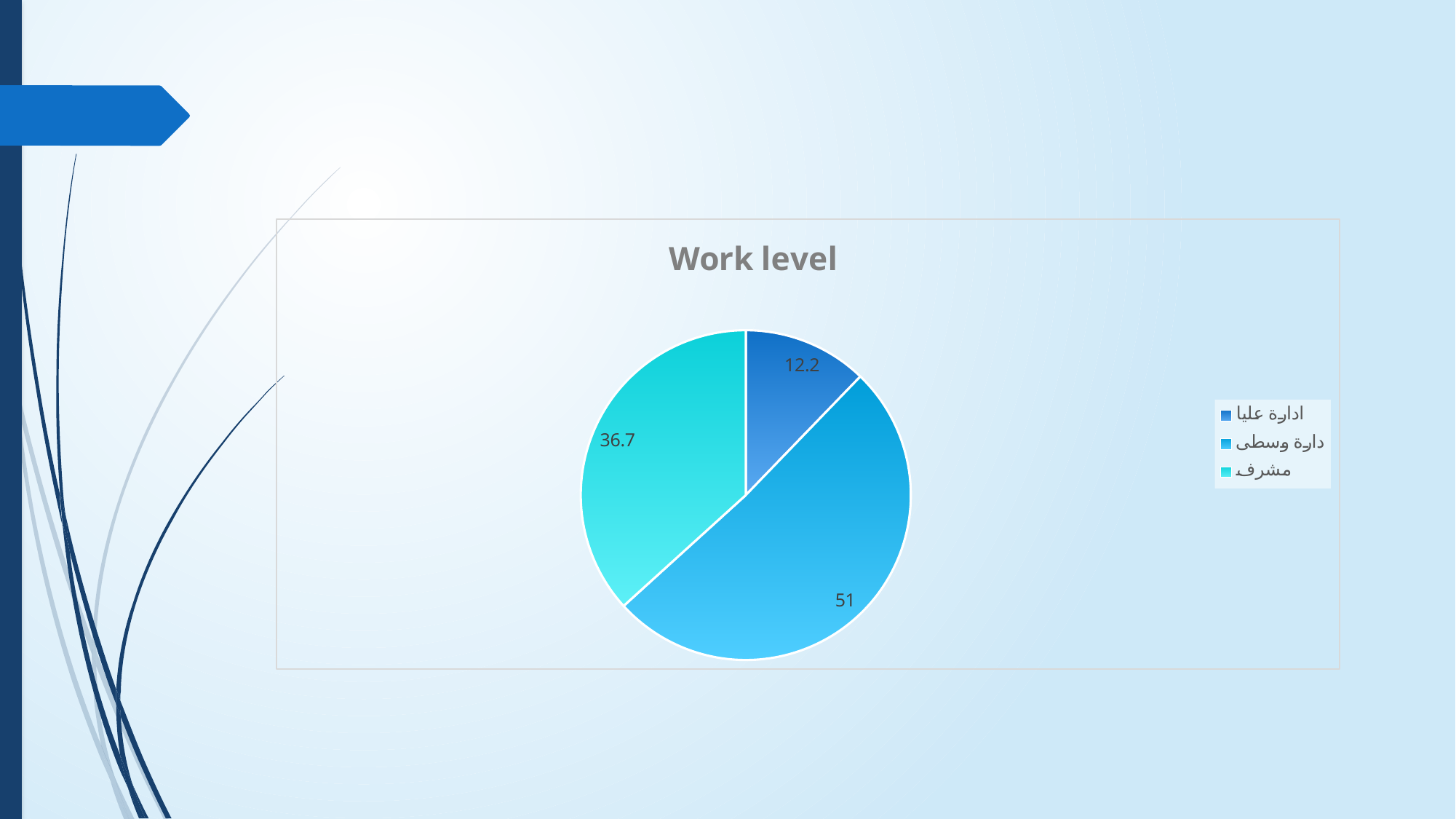
Which is larger, the value for مشرف or the value for ادارة عليا? مشرف What is the difference between the values for دارة وسطى and مشرف? 14.3 What is the difference between the values for مشرف and ادارة عليا? 24.5 How many slices does the Work level pie chart have? 3 What type of chart is shown on the slide? pie chart How many entries does the legend list? 3 Which category has the smallest slice in the Work level pie chart? ادارة عليا What is the value for مشرف in the Work level pie chart? 36.7 What is the value for دارة وسطى in the Work level pie chart? 51 What is the title of the chart? Work level Which category has the largest slice in the Work level pie chart? دارة وسطى What is the value for ادارة عليا in the Work level pie chart? 12.2